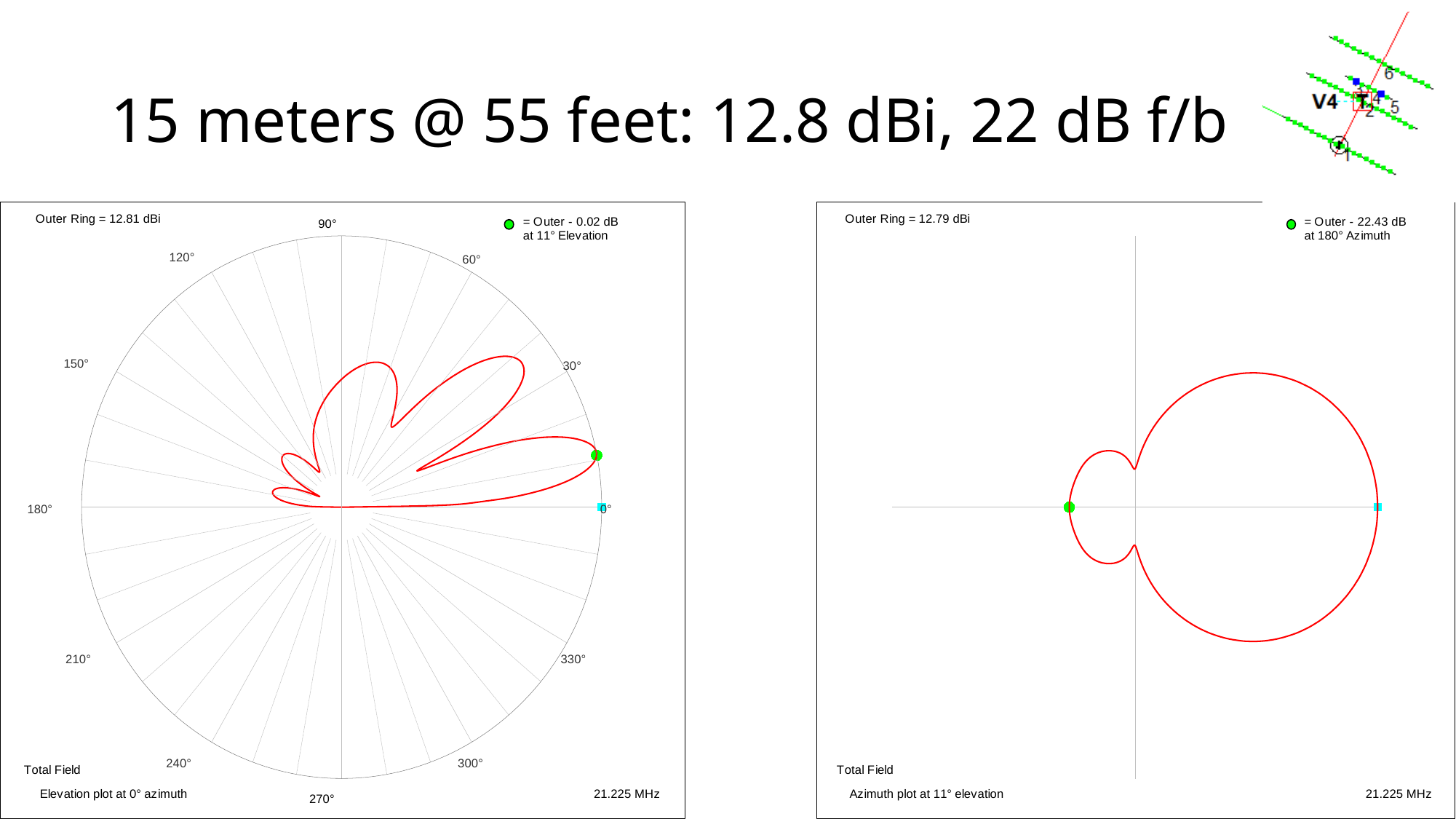
Which chart has the larger Outer Ring value, the left elevation plot or the right azimuth plot? The left elevation plot On the right chart (Azimuth plot at 11° elevation), what is the Outer Ring value? 12.79 dBi On the left chart (Elevation plot at 0° azimuth), how many angle labels are printed around the outer ring? 12 What is the difference between the Outer Ring values of the left elevation plot and the right azimuth plot? 0.02 dBi On the left chart (Elevation plot at 0° azimuth), how far below the outer ring is the green marker, and at what elevation? Outer - 0.02 dB at 11° Elevation What is the title of the slide? 15 meters @ 55 feet: 12.8 dBi, 22 dB f/b On the left chart (Elevation plot at 0° azimuth), what frequency is shown in the bottom right corner? 21.225 MHz On the right chart (Azimuth plot at 11° elevation), what frequency is shown in the bottom right corner? 21.225 MHz What kind of chart is the left chart (Elevation plot at 0° azimuth)? Polar (radar) chart On the right chart, what is the plot description printed at the bottom left? Azimuth plot at 11° elevation On the left chart (Elevation plot at 0° azimuth), what is the Outer Ring value? 12.81 dBi On the right chart (Azimuth plot at 11° elevation), how far below the outer ring is the green marker, and at what azimuth? Outer - 22.43 dB at 180° Azimuth